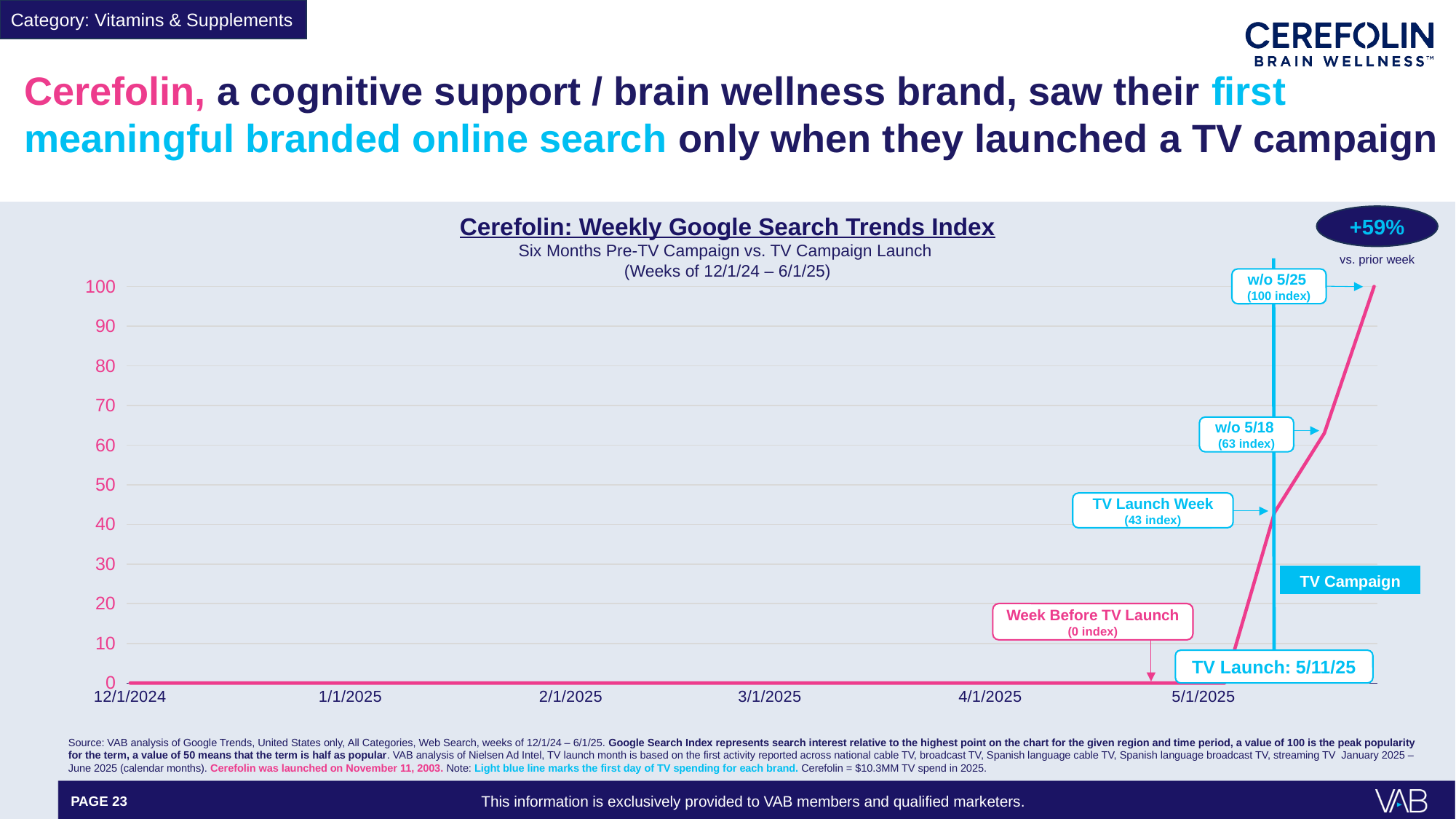
What is the difference in search index between the TV Launch Week and the week before the TV launch? 43 Which labeled week has the highest search index value? w/o 5/25 Does the search index rise or fall after the TV launch on 5/11/25? Rise What is the difference in search index between the week of 5/25 and the week of 5/18? 37 What is the search index value for the week of 5/25? 100 What is the search index value for the TV Launch Week? 43 What kind of chart is shown on the slide? Line chart What date is given for the TV launch on the chart? 5/11/25 What is the title of the chart? Cerefolin: Weekly Google Search Trends Index Which is larger, the search index for the week of 5/18 or for the TV Launch Week? w/o 5/18 What is the search index value for the week before the TV launch? 0 What is the search index value for the week of 5/18? 63